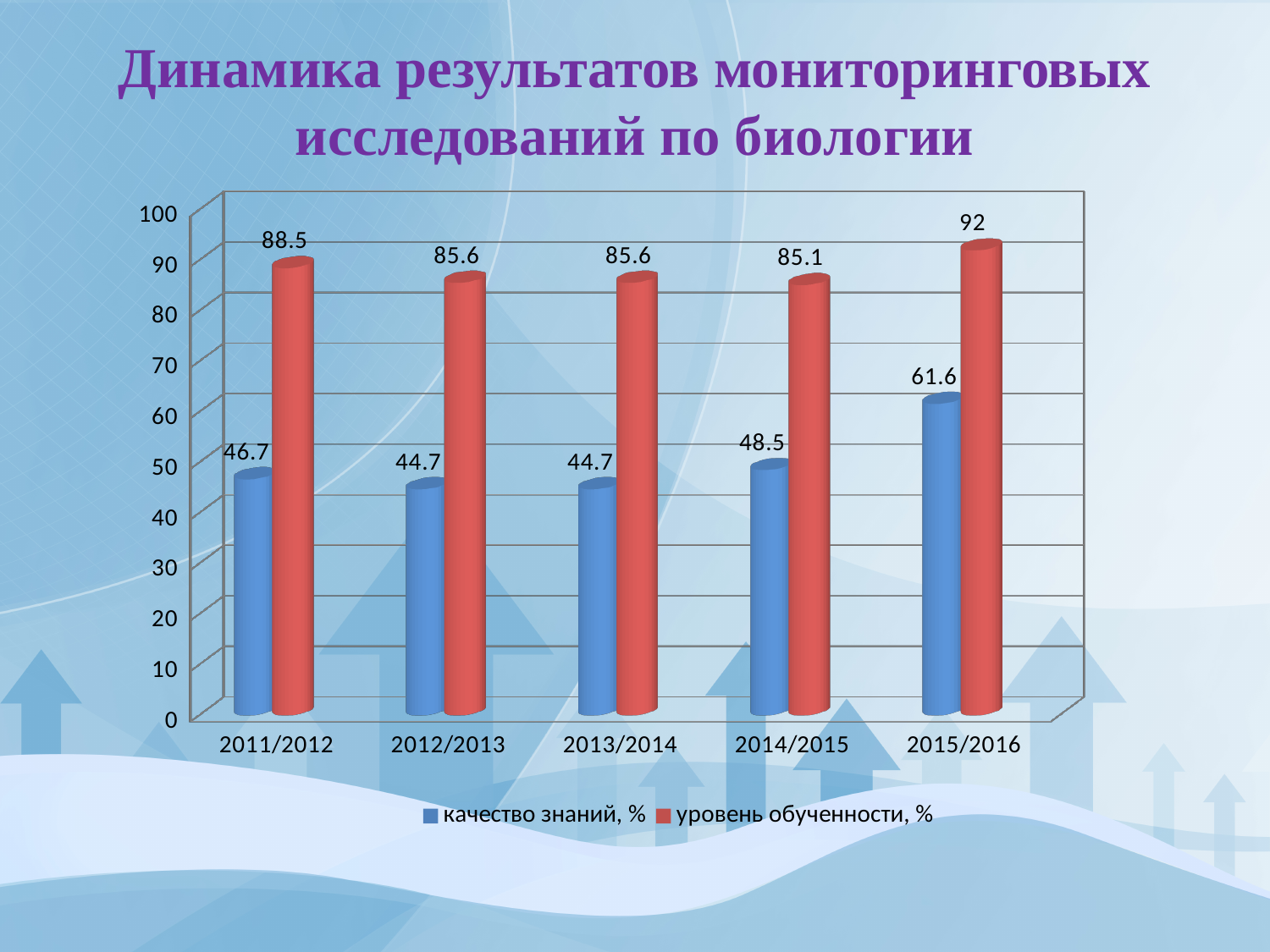
How many series does the legend list? 2 How many academic years are shown on the x axis? 5 What is the value of 'уровень обученности, %' for 2011/2012? 88.5 What kind of chart is shown on the slide? bar chart Which year has the lowest value for 'уровень обученности, %'? 2014/2015 What is the difference between 'уровень обученности, %' and 'качество знаний, %' in 2015/2016? 30.4 What is the value of 'качество знаний, %' for 2014/2015? 48.5 What is the value of 'качество знаний, %' for 2015/2016? 61.6 Which is larger: 'качество знаний, %' in 2011/2012 or in 2012/2013? 2011/2012 What colour are the bars for 'уровень обученности, %'? red Which year has the highest value for 'уровень обученности, %'? 2015/2016 Is the value of 'качество знаний, %' for 2013/2014 greater or less than 50? less